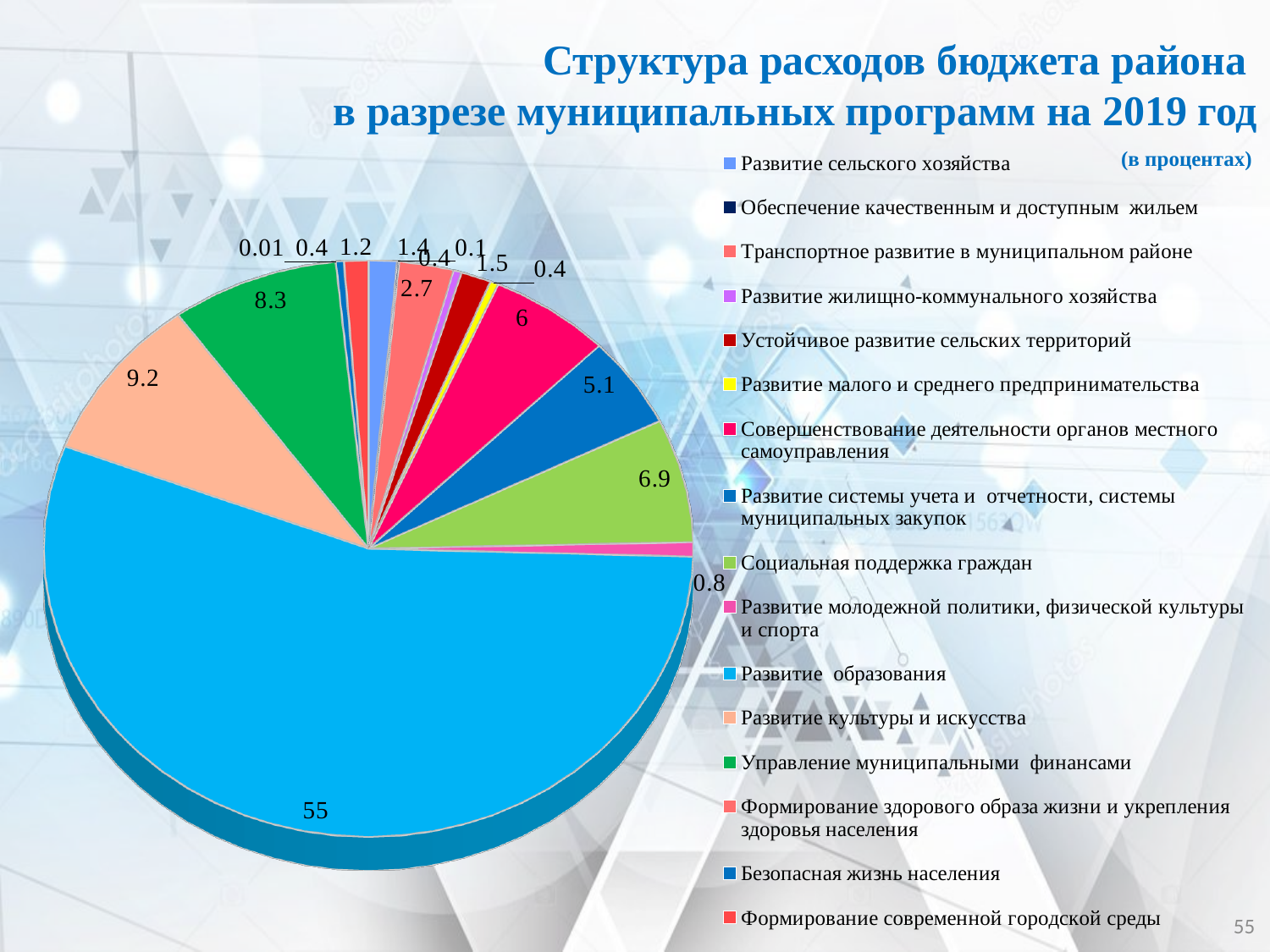
What is the value for Социальная поддержка граждан? 6.9 How many categories does the legend of the pie chart list? 16 What is the value for Развитие образования? 55 What is the value for Развитие культуры и искусства? 9.2 What is the difference between the values for Развитие культуры и искусства and Управление муниципальными финансами? 0.9 What is the value for Транспортное развитие в муниципальном районе? 2.7 What kind of chart is shown on the slide? pie chart Which category has the largest share of the pie? Развитие образования What is the smallest value labelled on the pie chart? 0.01 What is the value for Управление муниципальными финансами? 8.3 Which is larger: the value for Социальная поддержка граждан or the value for Совершенствование деятельности органов местного самоуправления? Социальная поддержка граждан What is the value for Развитие системы учета и отчетности, системы муниципальных закупок? 5.1